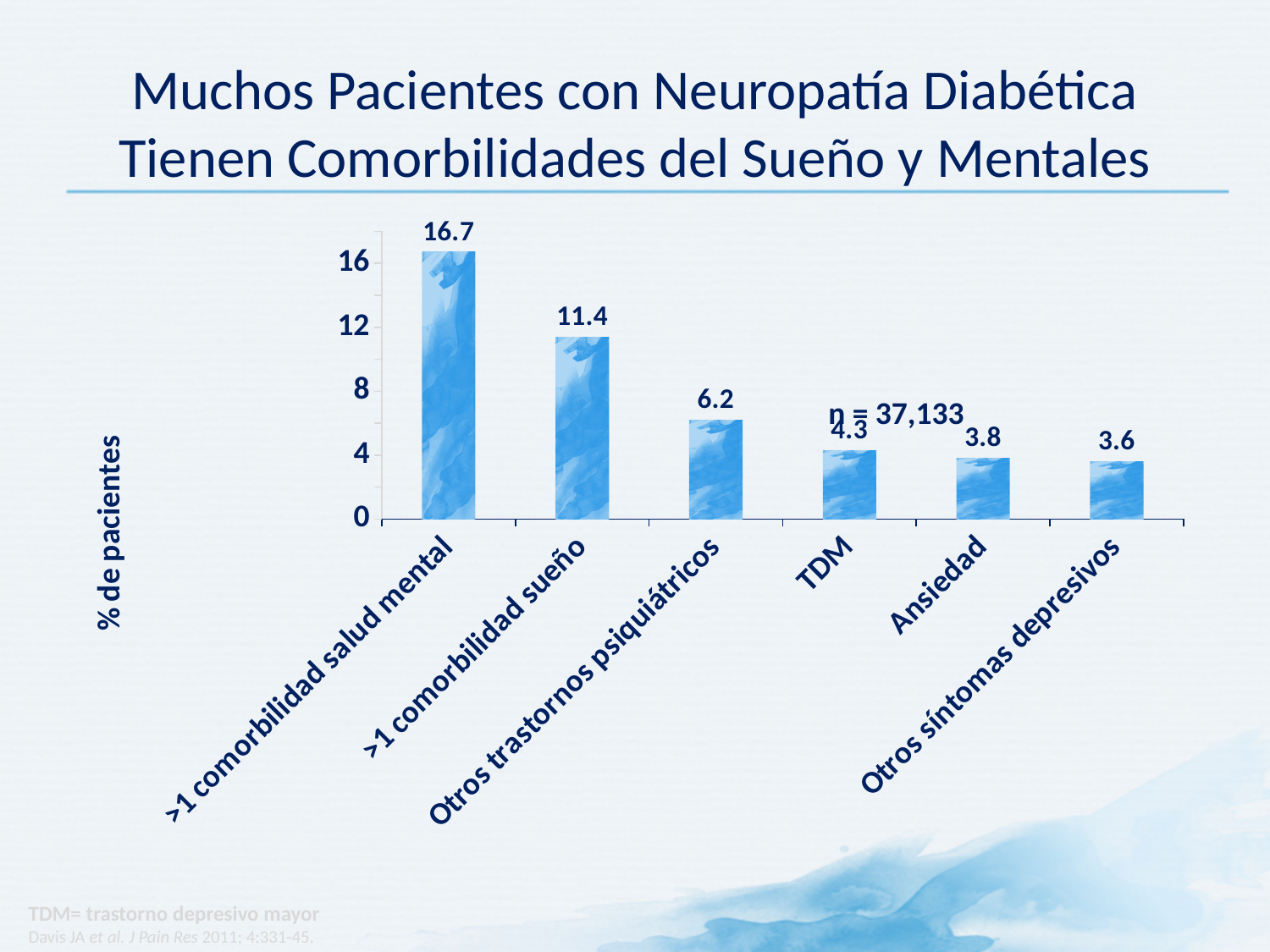
Is the value for '>1 comorbilidad sueño' greater or less than 8? greater What is the value for 'Ansiedad'? 3.8 Which category has the lowest value? Otros síntomas depresivos What is the label of the y axis? % de pacientes What is the difference between the values for '>1 comorbilidad salud mental' and '>1 comorbilidad sueño'? 5.3 What is the value for '>1 comorbilidad sueño'? 11.4 What is the value for 'Otros trastornos psiquiátricos'? 6.2 Which category has the highest value? >1 comorbilidad salud mental How many categories are shown in the chart? 6 What is the value for '>1 comorbilidad salud mental'? 16.7 Which is larger, the value for 'TDM' or the value for 'Otros trastornos psiquiátricos'? Otros trastornos psiquiátricos What kind of chart is shown on the slide? bar chart